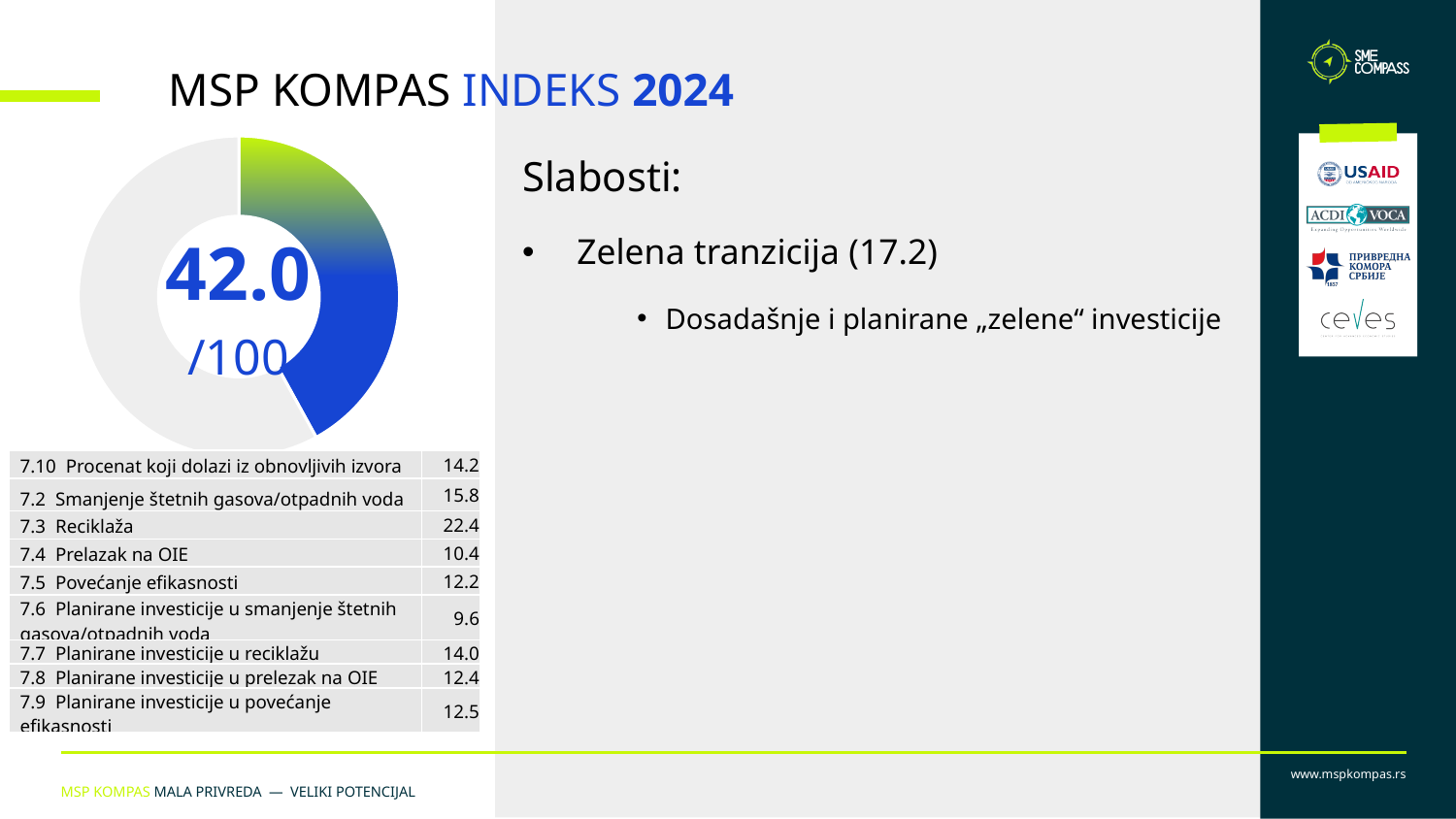
What share of the full circle does the coloured segment of the donut chart represent? 42.0% What colour is the unfilled remainder of the donut chart? Grey Is the value shown in the donut chart greater or less than 50? less What is the title of the slide containing the donut chart? MSP KOMPAS INDEKS 2024 What value is displayed in the centre of the donut chart? 42.0 What kind of chart is shown on the left of the slide? Donut (pie) chart Is the coloured segment of the donut chart larger or smaller than the grey segment? smaller Out of what maximum is the value in the donut chart expressed? 100